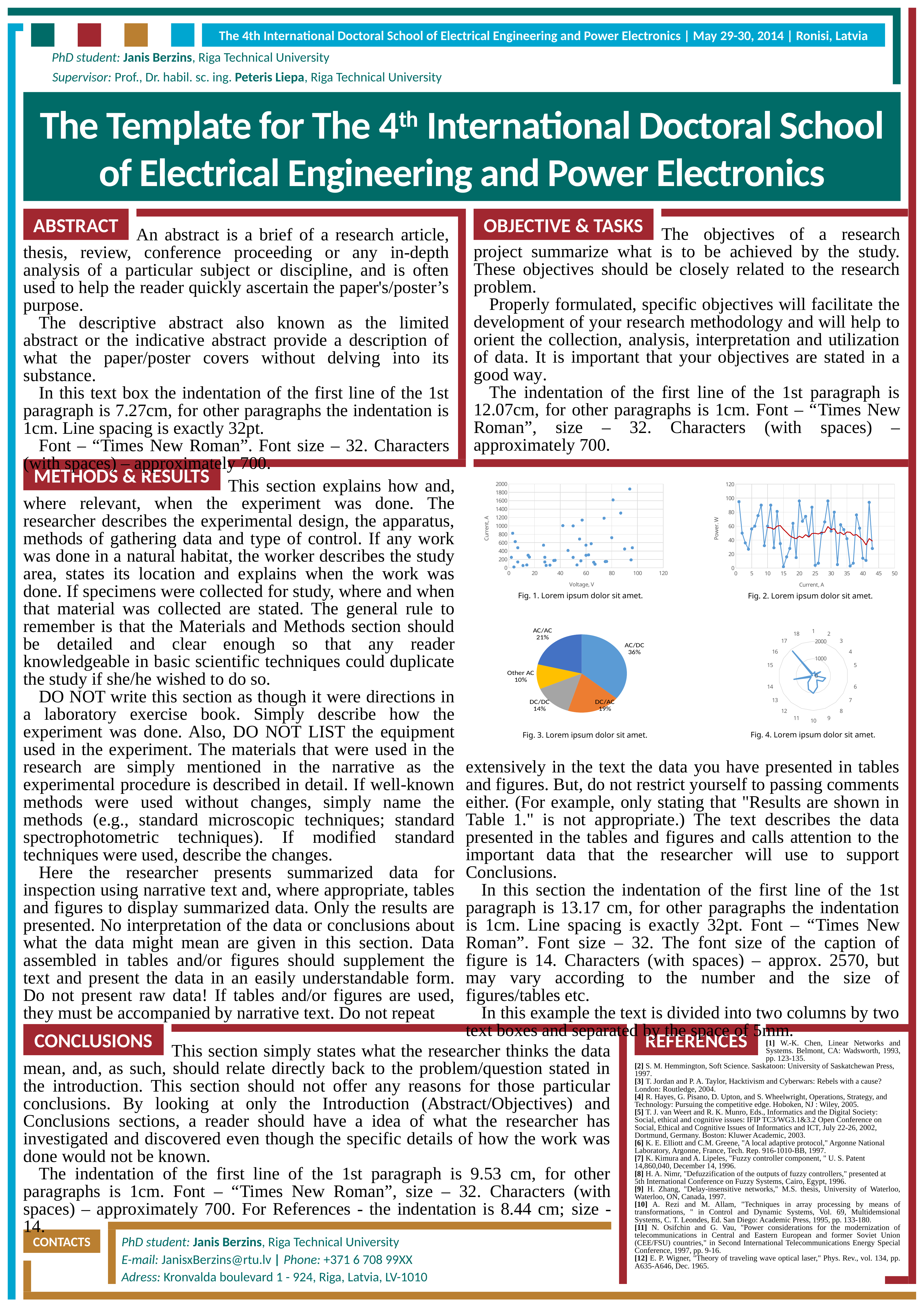
In Fig. 3, which slice is larger, AC/AC or DC/AC? AC/AC In Fig. 3, what is the difference in percentage points between the AC/DC and DC/AC slices? 17 What kind of chart is Fig. 3? pie chart In Fig. 3, what percentage is shown for the DC/DC slice? 14% In Fig. 3, which slice has the smallest share? Other AC How many slices does the pie chart in Fig. 3 have? 5 In Fig. 3, what percentage share does the AC/DC slice have? 36% How many categories are arranged around the radar chart in Fig. 4? 18 In Fig. 3, what percentage is shown for the Other AC slice? 10% What is the x-axis label of the chart in Fig. 1? Voltage, V In Fig. 3, which slice has the largest share? AC/DC What kind of chart is Fig. 1? scatter chart